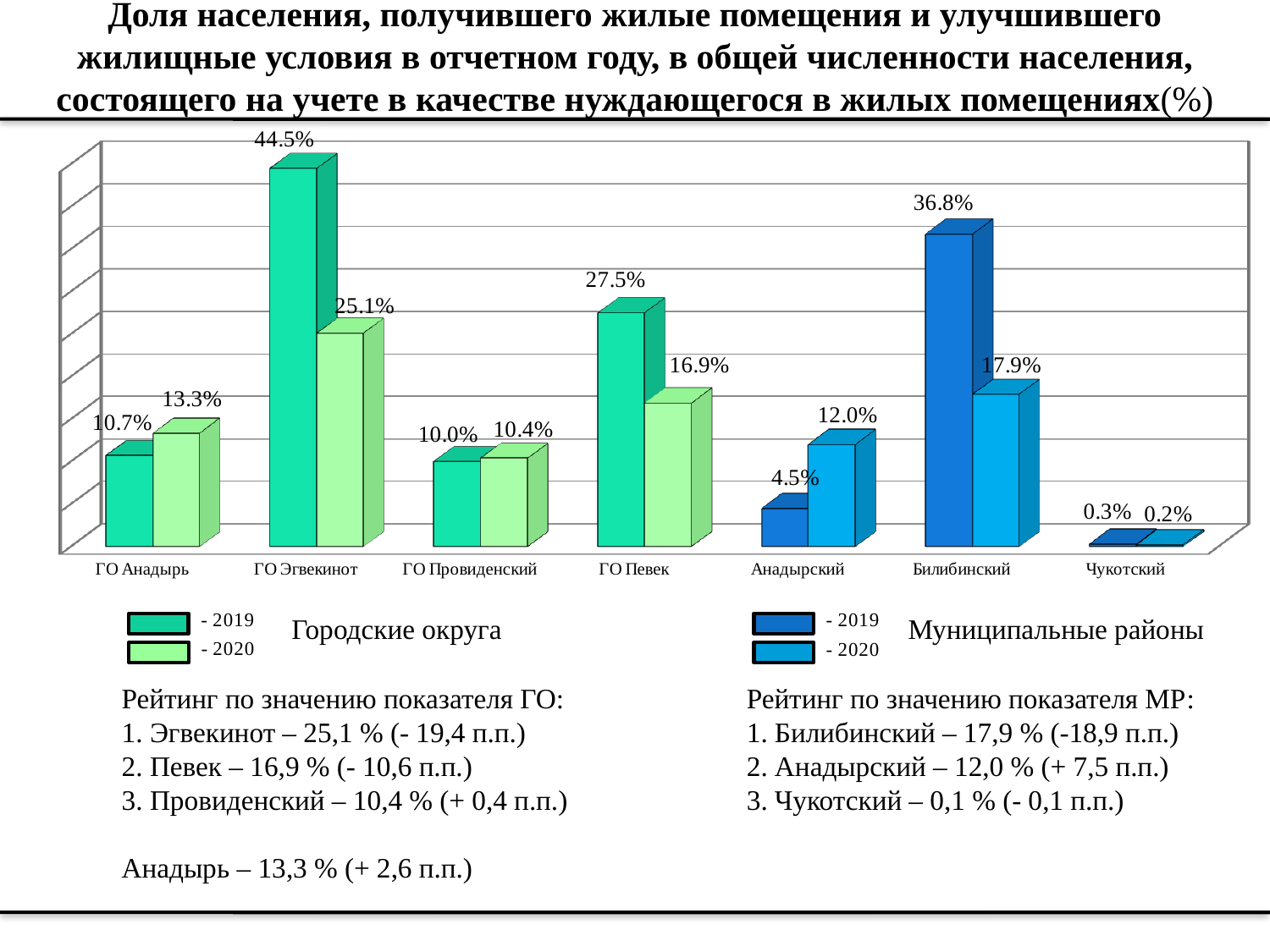
How many categories are shown on the x axis? 7 Which is larger for ГО Анадырь: the 2019 value or the 2020 value? 2020 Which category has the lowest 2020 value? Чукотский What kind of chart is shown on the slide? Bar chart What is the 2020 value for Билибинский? 17.9% Which category has the highest 2019 value? ГО Эгвекинот What is the difference between the 2019 and 2020 values for Анадырский? 7.5 percentage points Which two years are compared in the chart legend? 2019 and 2020 What is the difference between the 2019 and 2020 values for ГО Эгвекинот? 19.4 percentage points What is the 2020 value for Анадырский? 12.0% What is the 2019 value for ГО Эгвекинот? 44.5% What is the 2019 value for ГО Певек? 27.5%